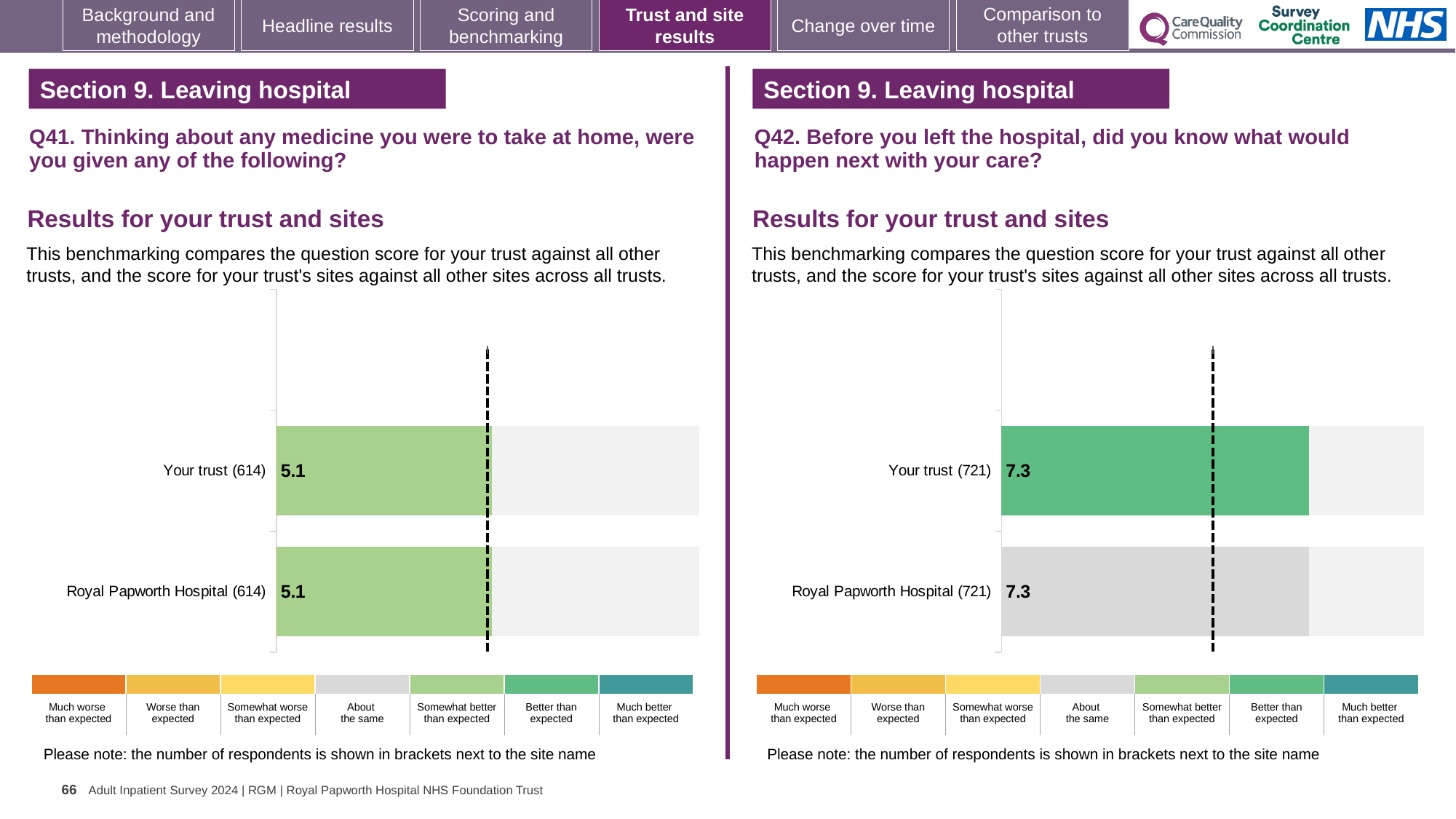
In the Q41 chart on the left, how many respondents are shown in brackets for Your trust? 614 How many benchmark categories does the colour key below the Q41 chart on the left list? 7 In the Q41 chart on the left, which benchmark category does the colour of the Your trust bar correspond to? Somewhat better than expected In the Q42 chart on the right, what is the score for Your trust? 7.3 How many bars are plotted in the Q41 chart on the left? 2 In the Q42 chart on the right, how many respondents are shown in brackets for Royal Papworth Hospital? 721 In the Q41 chart on the left, what is the score for Royal Papworth Hospital? 5.1 In the Q42 chart on the right, which benchmark category does the colour of the Royal Papworth Hospital bar correspond to? About the same What kind of chart is the Q42 chart on the right? Bar chart In the Q41 chart on the left, what is the score for Your trust? 5.1 In the Q42 chart on the right, what is the difference between the score for Your trust and the score for Royal Papworth Hospital? 0 In the Q42 chart on the right, what is the score for Royal Papworth Hospital? 7.3